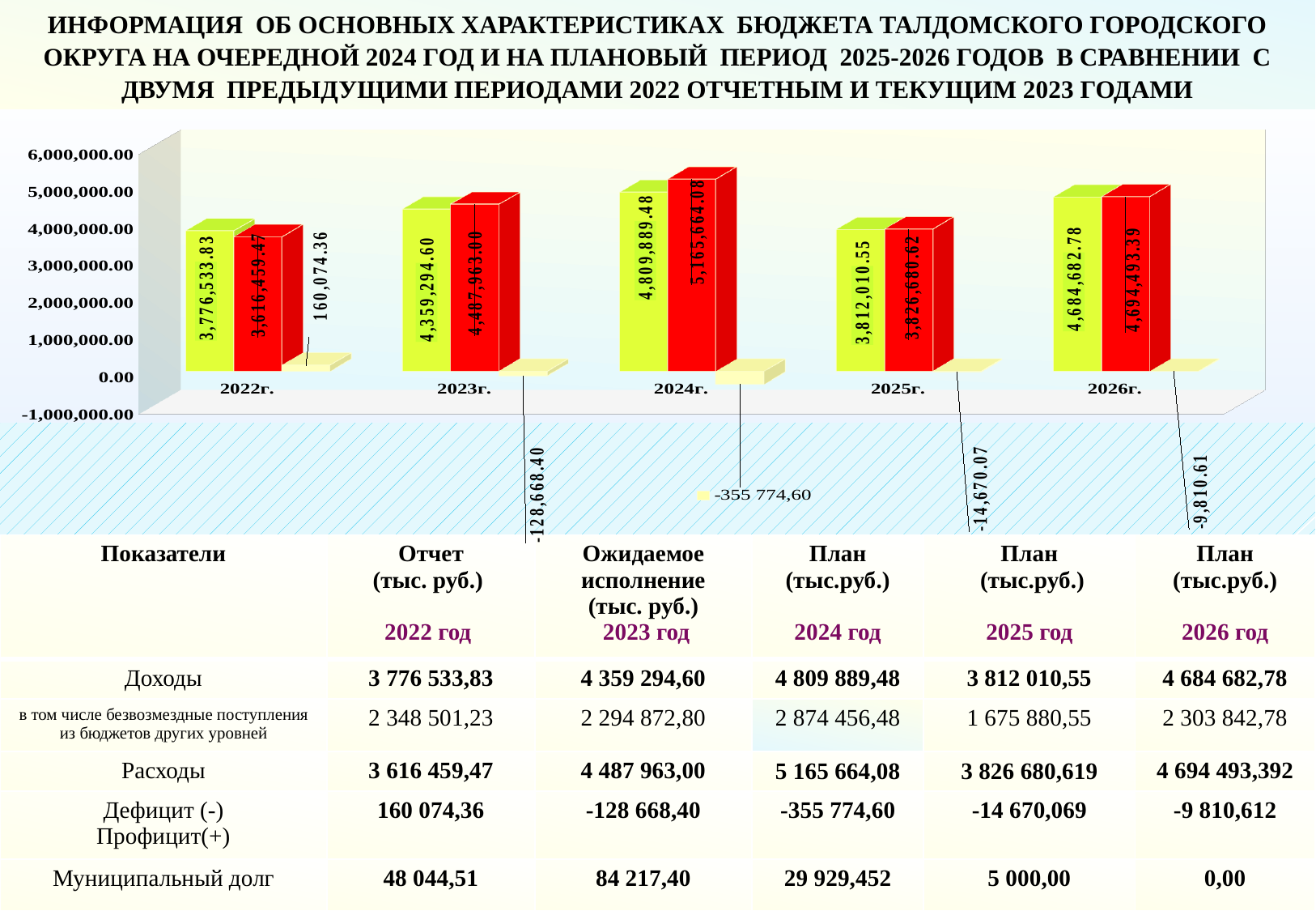
In which year is the red bar the lowest? 2022г. How many year categories are shown on the x axis of the chart? 5 What is the difference between the red bar and the green bar for 2024г.? 355,774.60 What value is printed for the yellow bar for 2025г.? -14,670.07 Is the value of the red bar for 2024г. greater or less than 5,000,000.00? greater In which year is the green bar the highest? 2024г. Which is larger, the green bar for 2023г. or the green bar for 2025г.? 2023г. What is the value printed on the green bar for 2026г.? 4,684,682.78 What is the value printed on the green bar for 2022г.? 3,776,533.83 What type of chart is shown on the slide? bar chart What is the value printed on the red bar for 2024г.? 5,165,664.08 Do the green bars rise or fall from 2022г. to 2024г.? rise